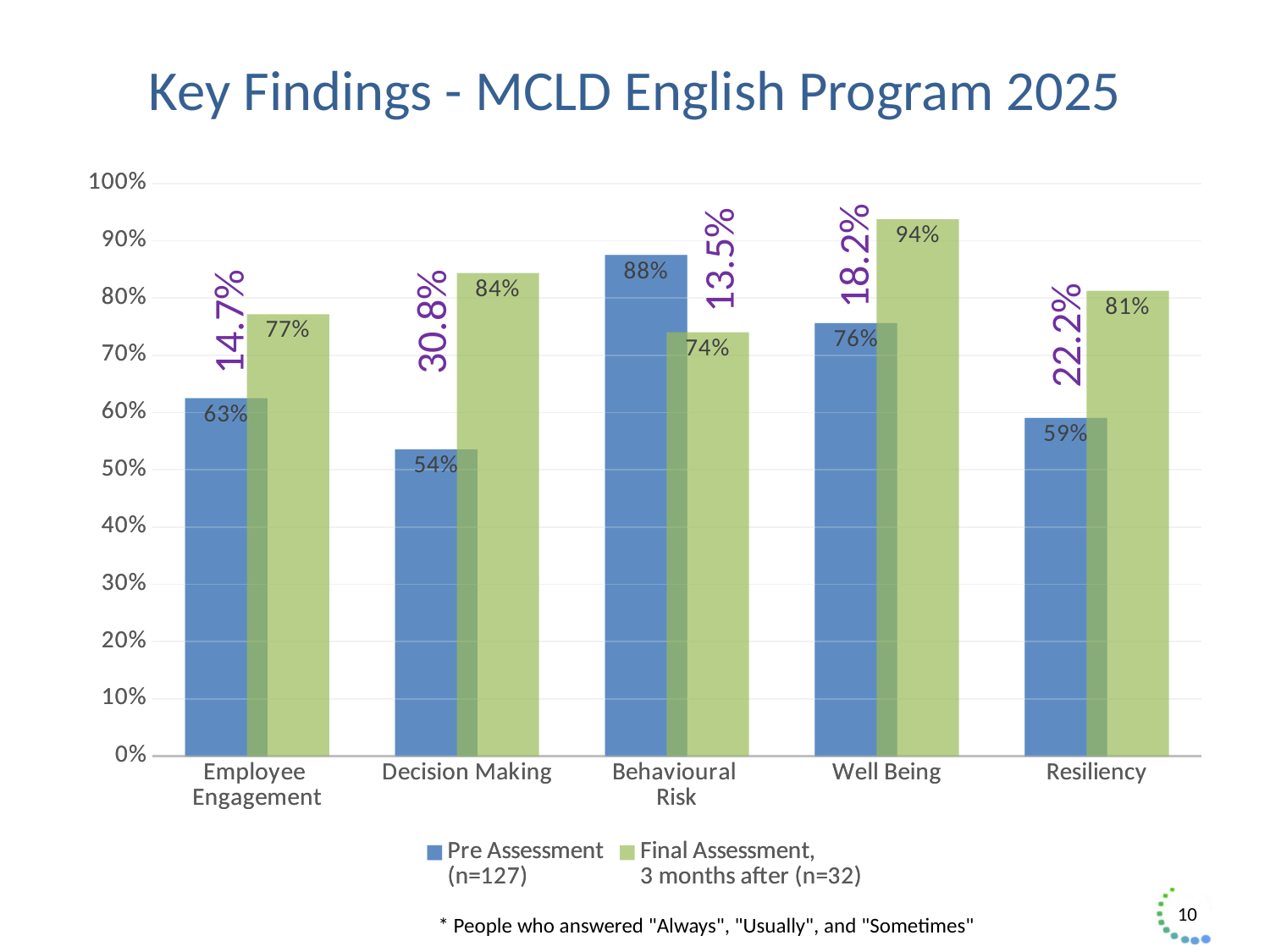
What is the difference between the Final Assessment and Pre Assessment values for Decision Making? 30% How many series does the legend list? 2 Is the Pre Assessment value for Resiliency greater or less than 70%? less What kind of chart is shown on the slide? bar chart What is the Pre Assessment value for Behavioural Risk? 88% How many categories are shown on the x axis? 5 What is the Final Assessment value for Well Being? 94% What is the Pre Assessment value for Employee Engagement? 63% For Behavioural Risk, which is larger: the Pre Assessment value or the Final Assessment value? Pre Assessment Which category has the highest Final Assessment value? Well Being Which category has the lowest Pre Assessment value? Decision Making What is the title of the slide? Key Findings - MCLD English Program 2025